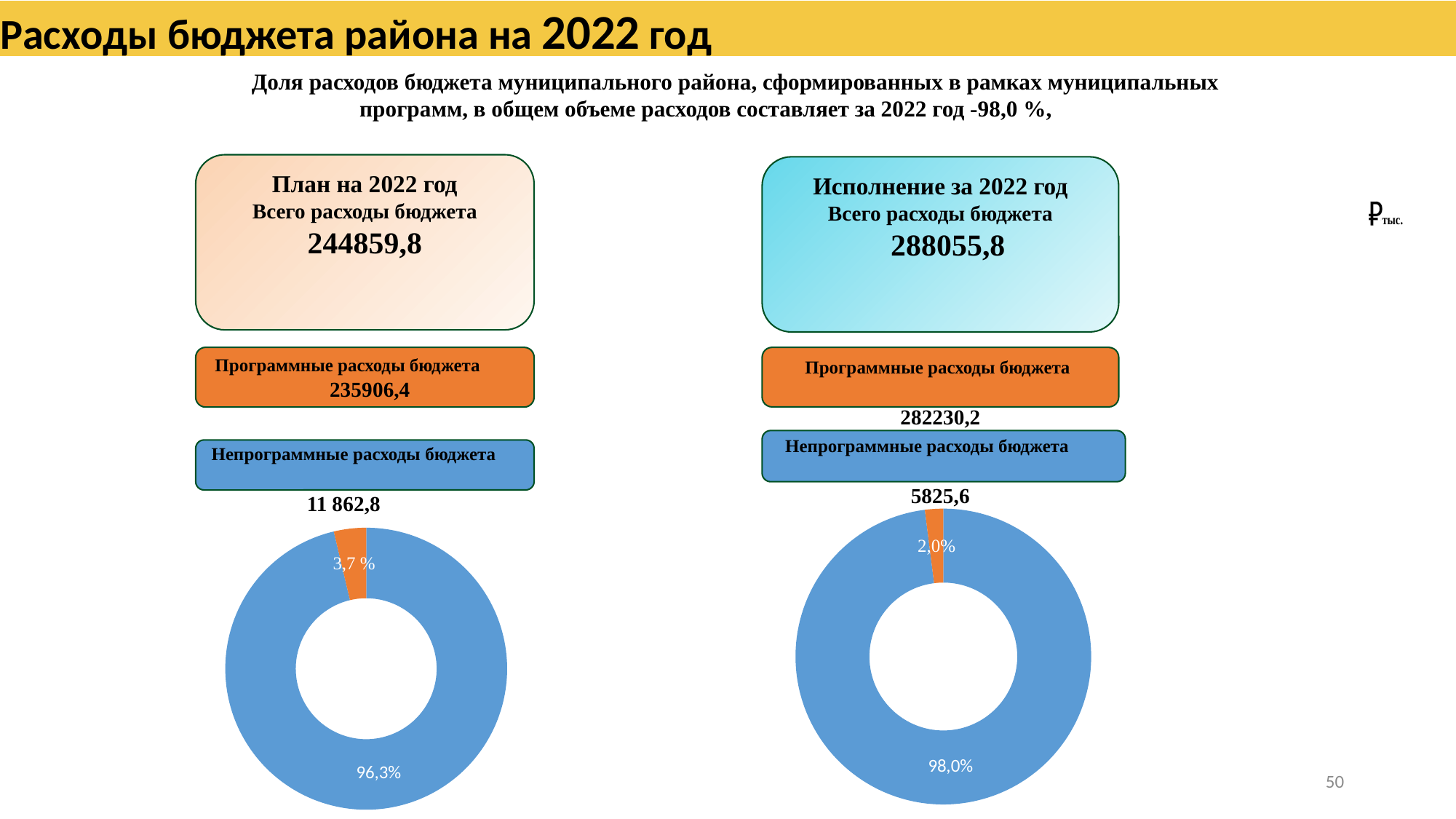
How many doughnut charts are shown on the slide? 2 In the right doughnut chart (under 'Исполнение за 2022 год'), what share is shown for the large blue slice? 98,0% In the left doughnut chart (under 'План на 2022 год'), what share is shown for the large blue slice? 96,3% In the right doughnut chart (under 'Исполнение за 2022 год'), which slice is the smallest? The orange slice (2,0%) What kind of chart is shown under the 'План на 2022 год' box on the left? Doughnut (pie) chart In the left doughnut chart (under 'План на 2022 год'), what share is shown for the small orange slice? 3,7 % Which is larger: the blue slice share in the left doughnut chart (96,3%) or the blue slice share in the right doughnut chart (98,0%)? The right chart's blue slice (98,0%) In the left doughnut chart (under 'План на 2022 год'), what is the difference in percentage points between the blue slice and the orange slice? 92,6 percentage points How many slices does the left doughnut chart (under 'План на 2022 год') have? 2 In the right doughnut chart (under 'Исполнение за 2022 год'), what is the difference in percentage points between the blue slice and the orange slice? 96,0 percentage points In the left doughnut chart (under 'План на 2022 год'), which slice is the largest? The blue slice (96,3%)